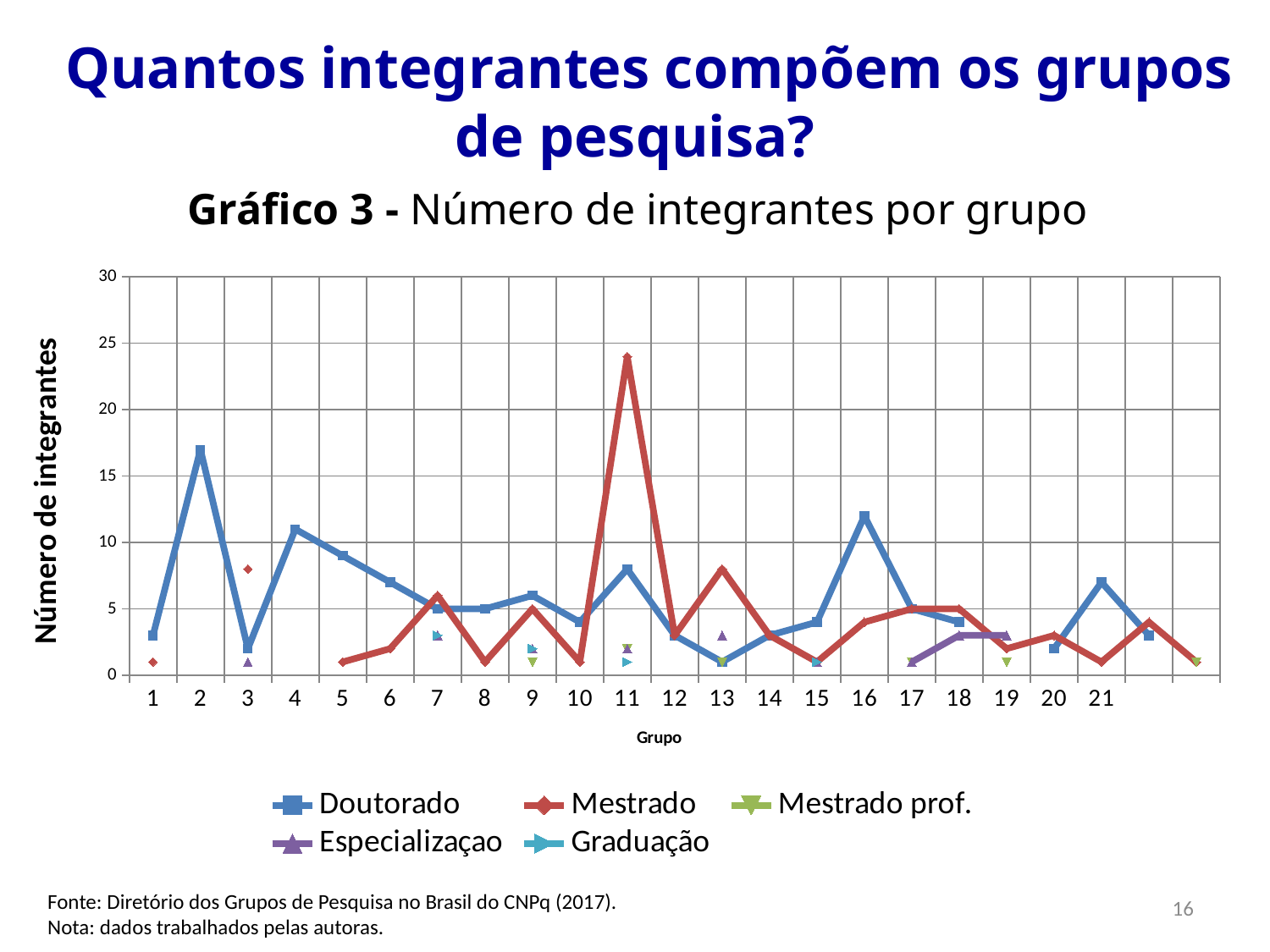
What kind of chart is shown on the slide? line chart Is the Doutorado value for group 2 greater or less than 15? greater For which group does the Mestrado series reach its highest value? 11 For which group does the Doutorado series reach its highest value? 2 How many series does the legend list? 5 At group 11, which series has the larger value, Doutorado or Mestrado? Mestrado At group 16, which series has the larger value, Doutorado or Mestrado? Doutorado Is the Mestrado value for group 3 greater or less than 10? less Is the Mestrado value for group 11 greater or less than 20? greater Does the Mestrado series rise or fall from group 11 to group 12? fall What is the label of the vertical axis? Número de integrantes